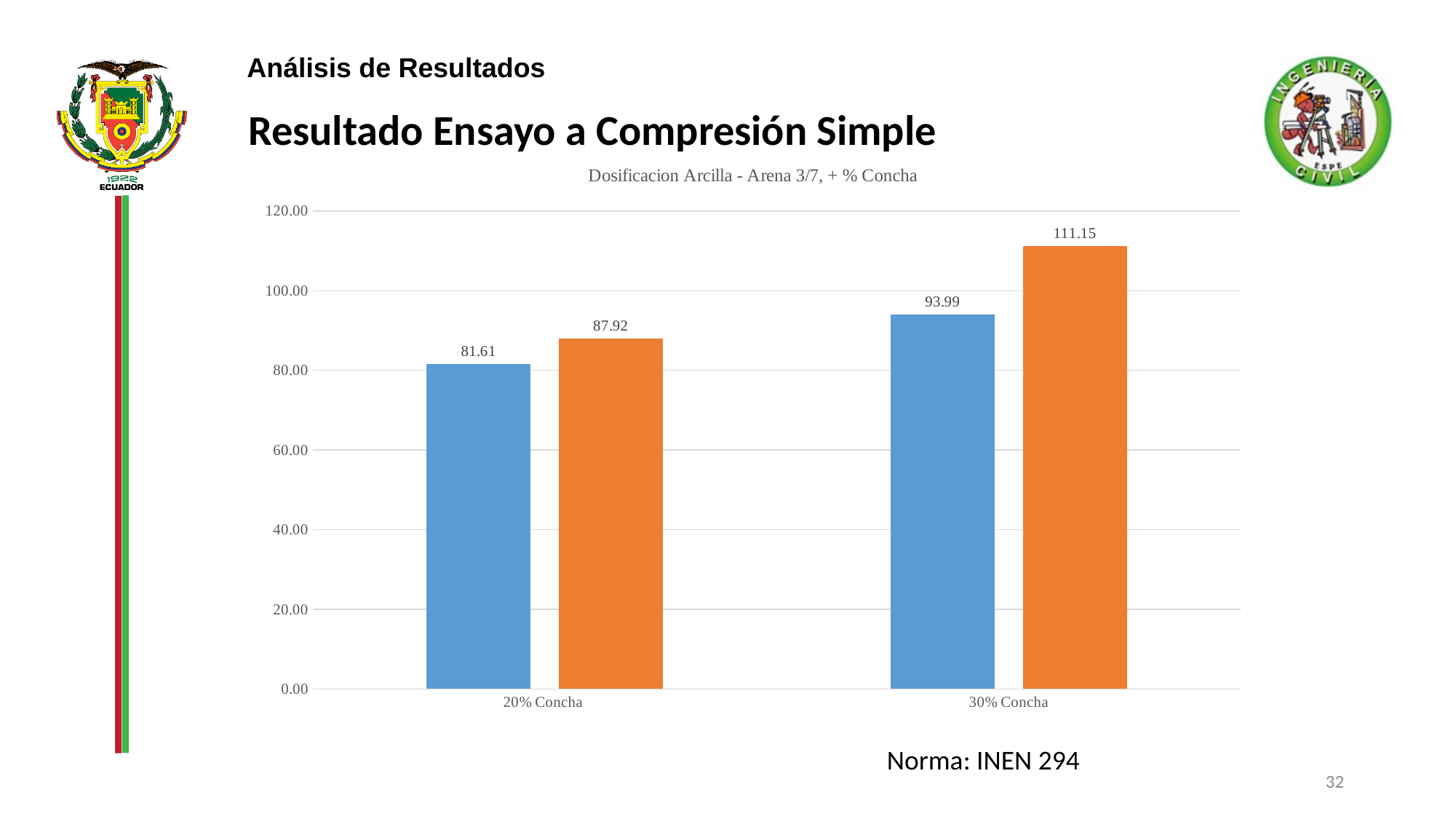
Which is larger, the blue bar for 30% Concha or the orange bar for 20% Concha? Blue bar for 30% Concha What is the difference between the orange and blue bars for 30% Concha? 17.16 What is the value of the orange bar for 30% Concha? 111.15 What type of chart is shown on the slide? Bar chart What is the value of the orange bar for 20% Concha? 87.92 What is the difference between the orange bar values for 30% Concha and 20% Concha? 23.23 How many categories are shown on the x axis? 2 Is the value of the orange bar for 30% Concha greater or less than 100.00? greater What is the value of the blue bar for 20% Concha? 81.61 What is the value of the blue bar for 30% Concha? 93.99 Which bar has the lowest value in the chart? Blue bar for 20% Concha (81.61) Which bar has the highest value in the chart? Orange bar for 30% Concha (111.15)